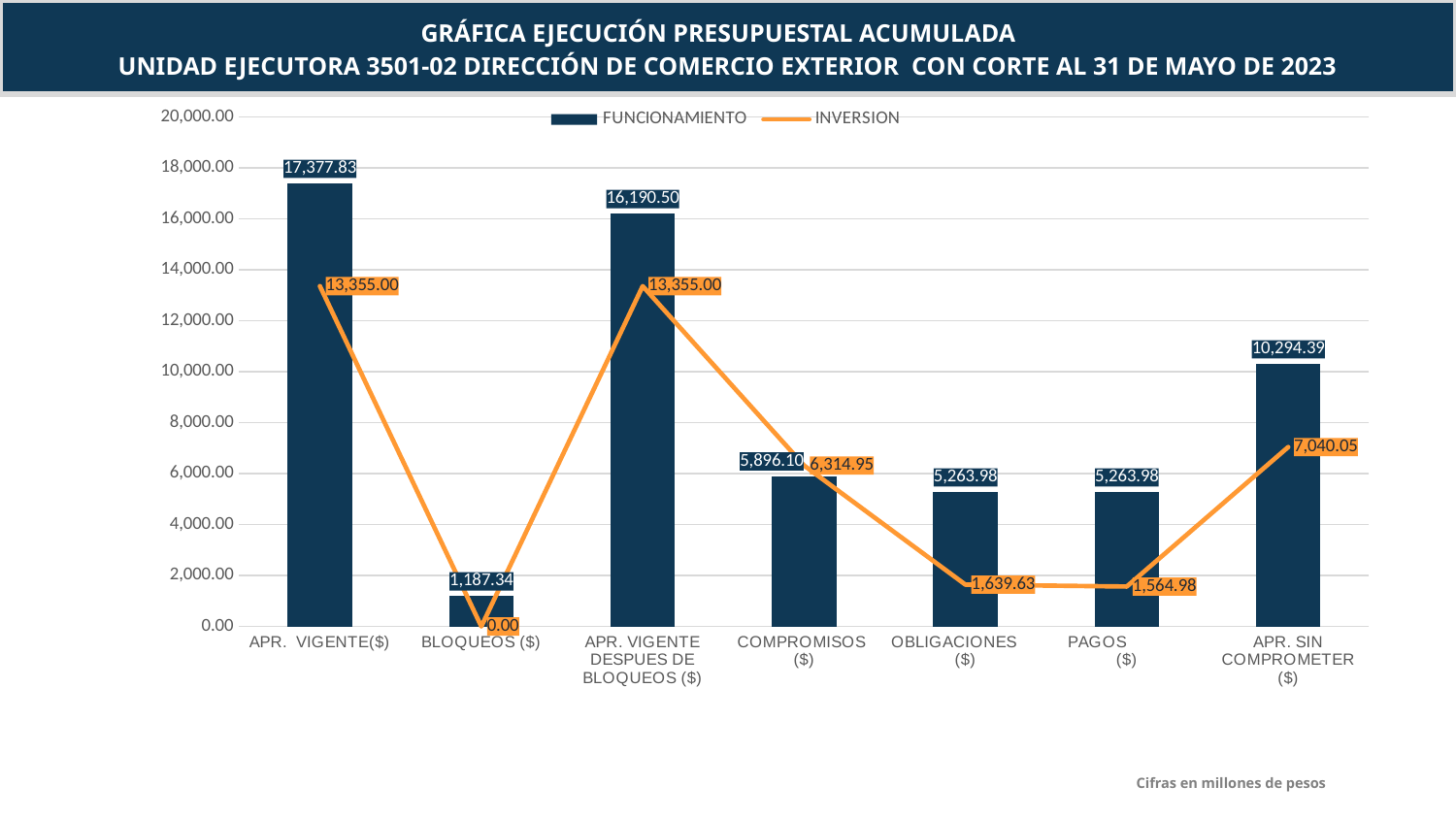
Which series is drawn as a line? INVERSION What is the INVERSION value for COMPROMISOS ($)? 6,314.95 Which category has the lowest INVERSION value? BLOQUEOS ($) How many series does the legend list? 2 What is the difference between the INVERSION values for OBLIGACIONES ($) and PAGOS ($)? 74.65 Which is larger for COMPROMISOS ($): the FUNCIONAMIENTO value or the INVERSION value? INVERSION What is the FUNCIONAMIENTO value for APR. SIN COMPROMETER ($)? 10,294.39 What is the FUNCIONAMIENTO value for APR. VIGENTE($)? 17,377.83 Which category has the highest FUNCIONAMIENTO value? APR. VIGENTE($) What is the difference between the FUNCIONAMIENTO values for APR. VIGENTE($) and APR. VIGENTE DESPUES DE BLOQUEOS ($)? 1,187.33 How many categories are shown on the x axis? 7 What is the INVERSION value for BLOQUEOS ($)? 0.00